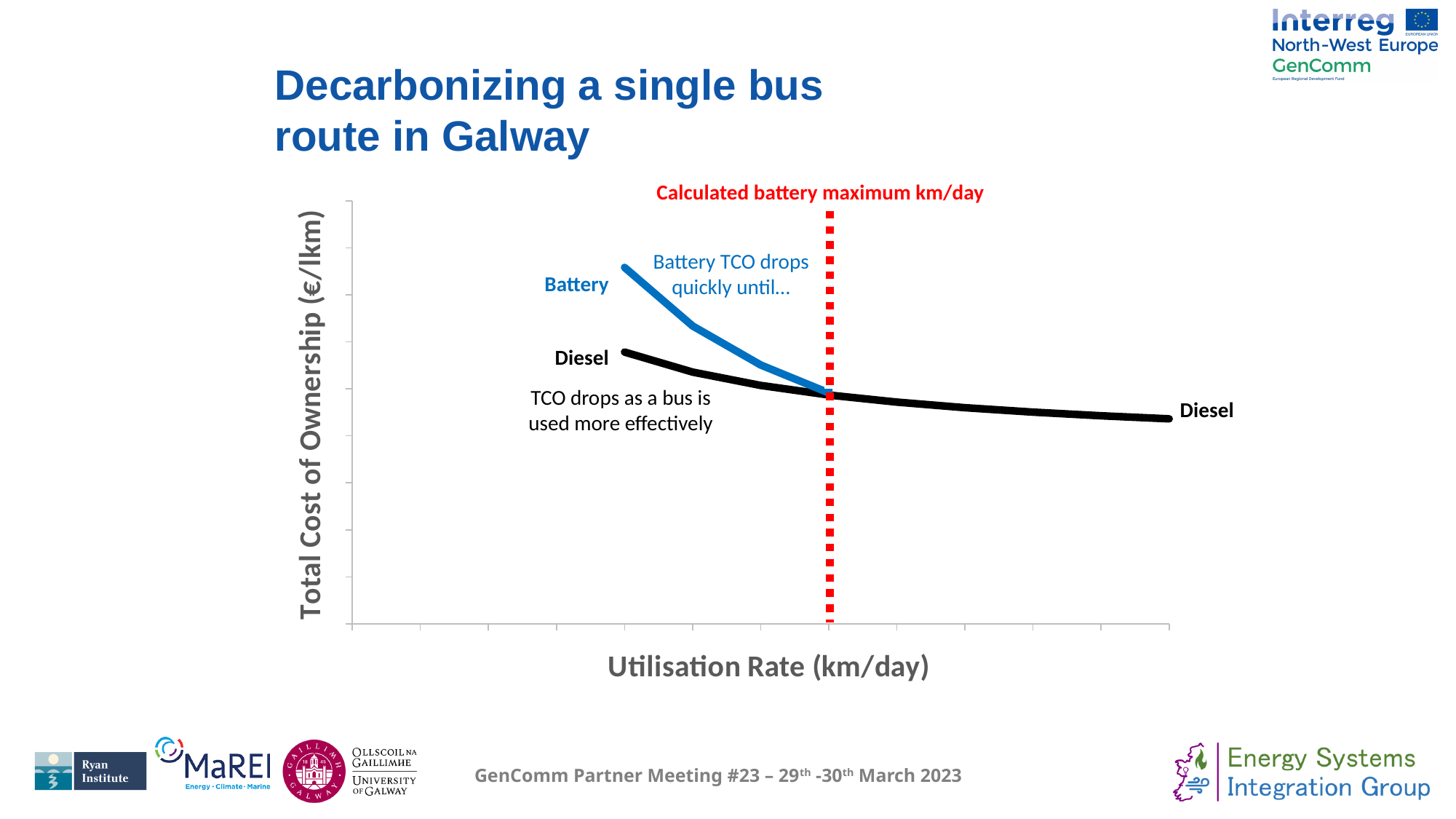
Does the Battery line rise or fall as the utilisation rate increases? fall Which series drops more steeply as utilisation rate increases, Battery or Diesel? Battery What does the red dashed vertical line on the chart represent? Calculated battery maximum km/day At low utilisation rates, which series has the higher total cost of ownership, Battery or Diesel? Battery What is the label of the x axis? Utilisation Rate (km/day) Does the Diesel line rise or fall as the utilisation rate increases? fall What colour is the Battery line on the chart? blue How many data series are plotted on the chart? 2 Which series extends further along the x axis, Battery or Diesel? Diesel What kind of chart is shown on the slide? line chart